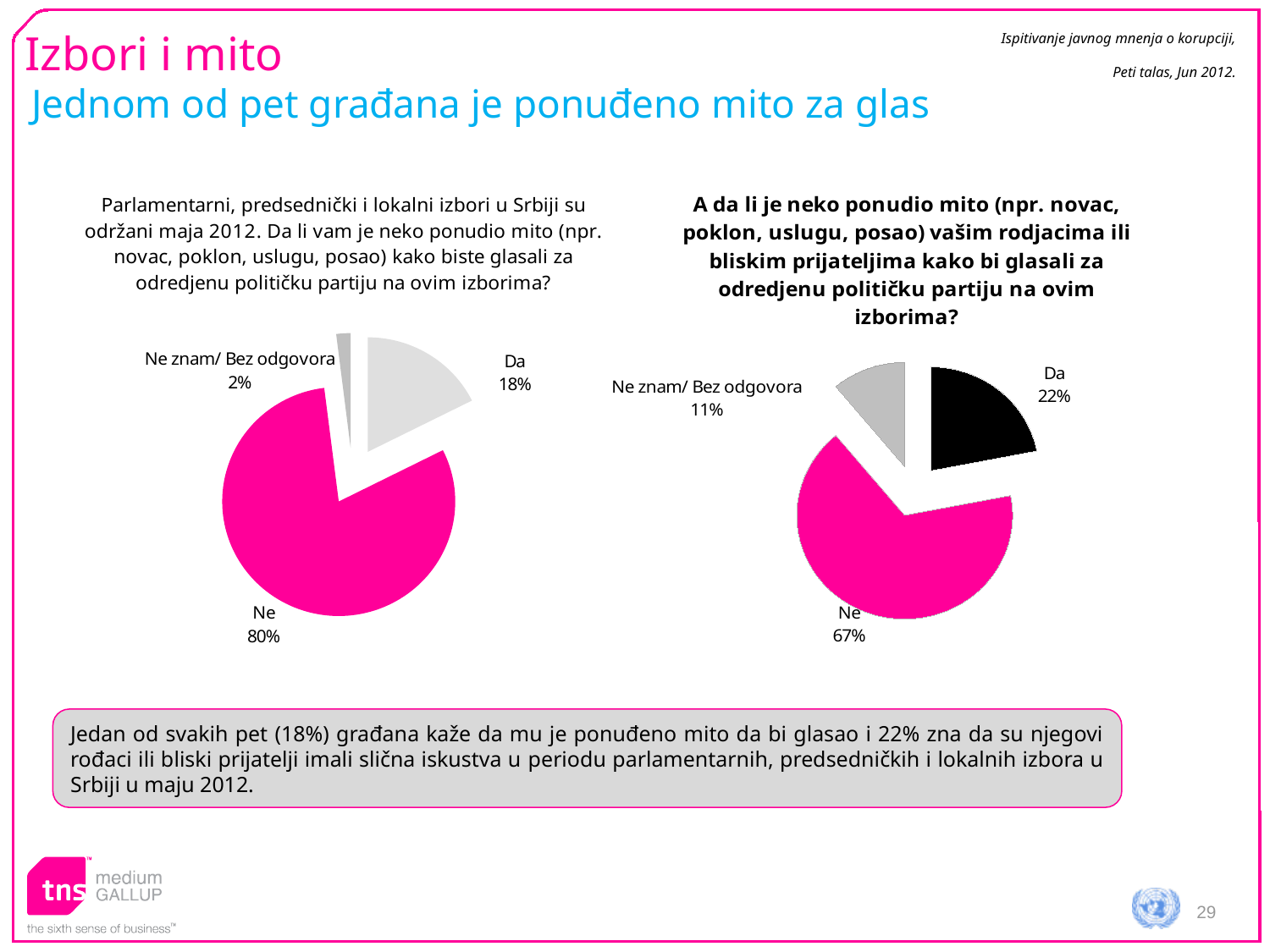
In the left pie chart, which category has the largest share? Ne In the left pie chart, what percentage of respondents answered "Ne"? 80% What is the difference in percentage points between "Ne" in the left pie chart and "Ne" in the right pie chart? 13 In the right pie chart, what percentage of respondents answered "Da"? 22% What type of chart is used on the left side of the slide? Pie chart How many slices does the right pie chart have? 3 Which is larger: the "Da" share in the left pie chart or the "Da" share in the right pie chart? Right pie chart (22%) In the left pie chart, what is the share for "Ne znam/ Bez odgovora"? 2% In the right pie chart, what percentage of respondents answered "Ne"? 67% In the right pie chart, which category has the smallest share? Ne znam/ Bez odgovora In the right pie chart, what is the share for "Ne znam/ Bez odgovora"? 11% In the left pie chart, what percentage of respondents answered "Da"? 18%